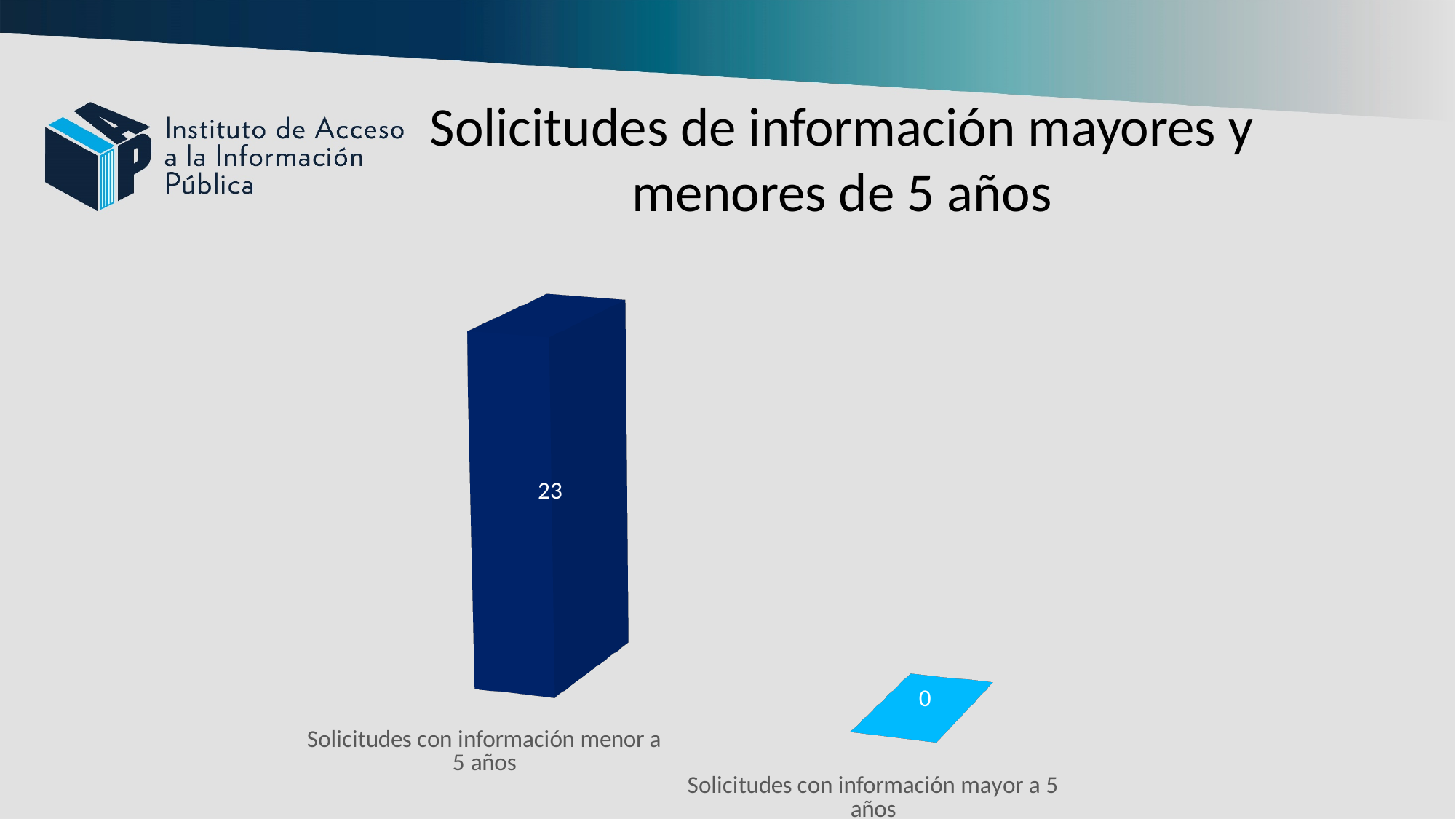
Which category has the lowest value? Solicitudes con información mayor a 5 años Which category has the highest value? Solicitudes con información menor a 5 años What kind of chart is shown on the slide? Bar chart What colour is the bar for 'Solicitudes con información menor a 5 años'? Dark blue What is the title of the slide containing the chart? Solicitudes de información mayores y menores de 5 años What is the difference between the values for 'Solicitudes con información menor a 5 años' and 'Solicitudes con información mayor a 5 años'? 23 What is the value for 'Solicitudes con información mayor a 5 años'? 0 What is the value for 'Solicitudes con información menor a 5 años'? 23 Which is larger: the value for 'Solicitudes con información menor a 5 años' or for 'Solicitudes con información mayor a 5 años'? Solicitudes con información menor a 5 años What is the total of the two values shown in the chart? 23 How many categories are shown in the chart? 2